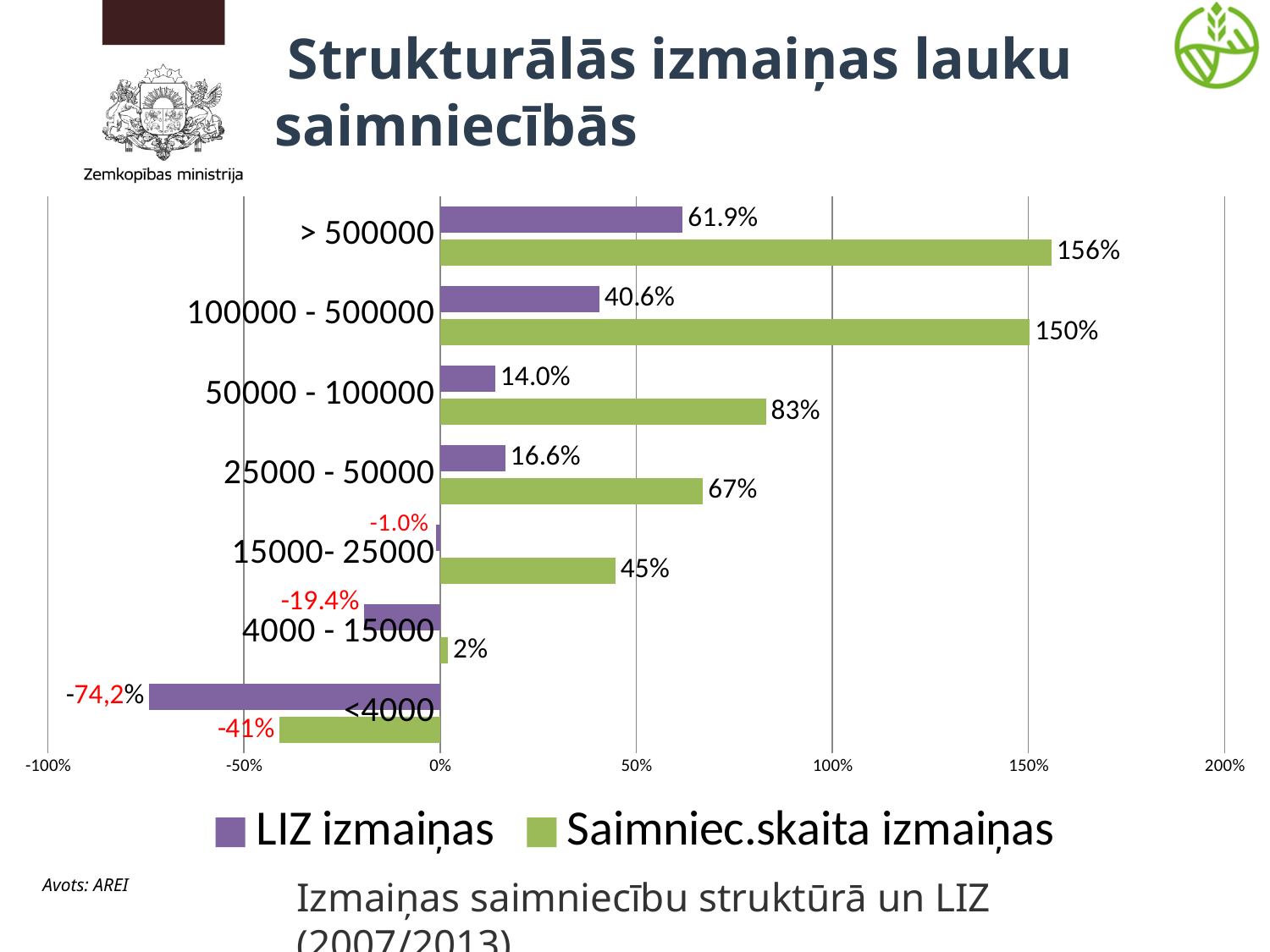
What is the value of LIZ izmaiņas for the > 500000 category? 61.9% What is the difference between the Saimniec.skaita izmaiņas values for 50000 - 100000 and 25000 - 50000? 16% What is the value of LIZ izmaiņas for the <4000 category? -74,2% How many series does the legend list? 2 What is the value of Saimniec.skaita izmaiņas for the 100000 - 500000 category? 150% Which is larger: LIZ izmaiņas for 25000 - 50000 or LIZ izmaiņas for 50000 - 100000? 25000 - 50000 Which colour represents Saimniec.skaita izmaiņas in the legend? Green What kind of chart is shown on the slide? Bar chart How many categories are shown on the chart? 7 What is the value of Saimniec.skaita izmaiņas for the 15000- 25000 category? 45% Which category has the lowest value for LIZ izmaiņas? <4000 Which category has the highest value for Saimniec.skaita izmaiņas? > 500000